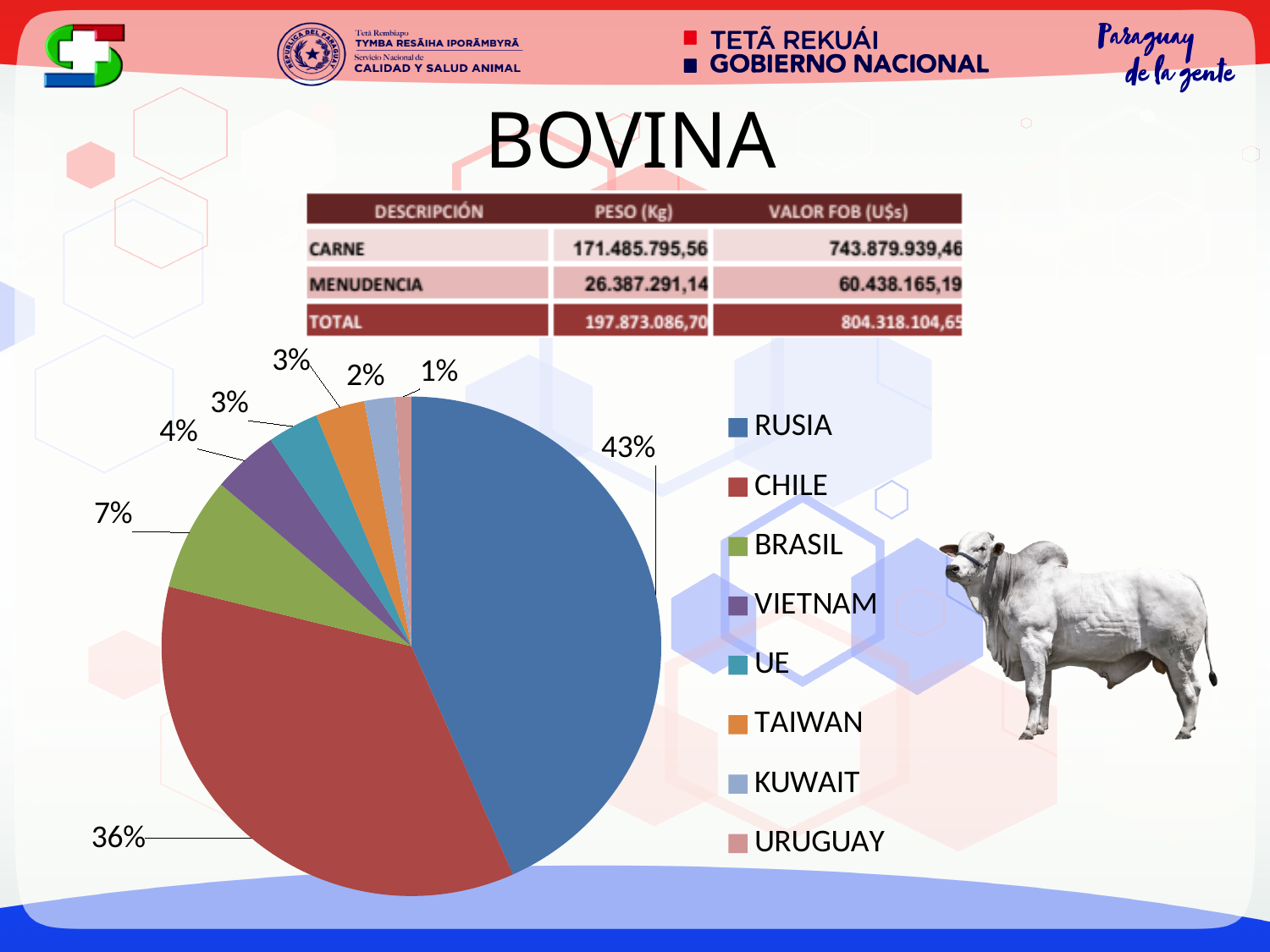
Which has a larger share, BRASIL or VIETNAM? BRASIL Which category has the smallest slice of the pie? URUGUAY What share of the pie does KUWAIT have? 2% What kind of chart is shown on the slide? pie chart What share of the pie does VIETNAM have? 4% How many categories does the legend of the pie chart list? 8 What colour is the slice for CHILE? red What share of the pie does CHILE have? 36% What is the difference in percentage points between RUSIA and CHILE? 7 What share of the pie does RUSIA have? 43% What share of the pie does BRASIL have? 7% Which category has the largest slice of the pie? RUSIA